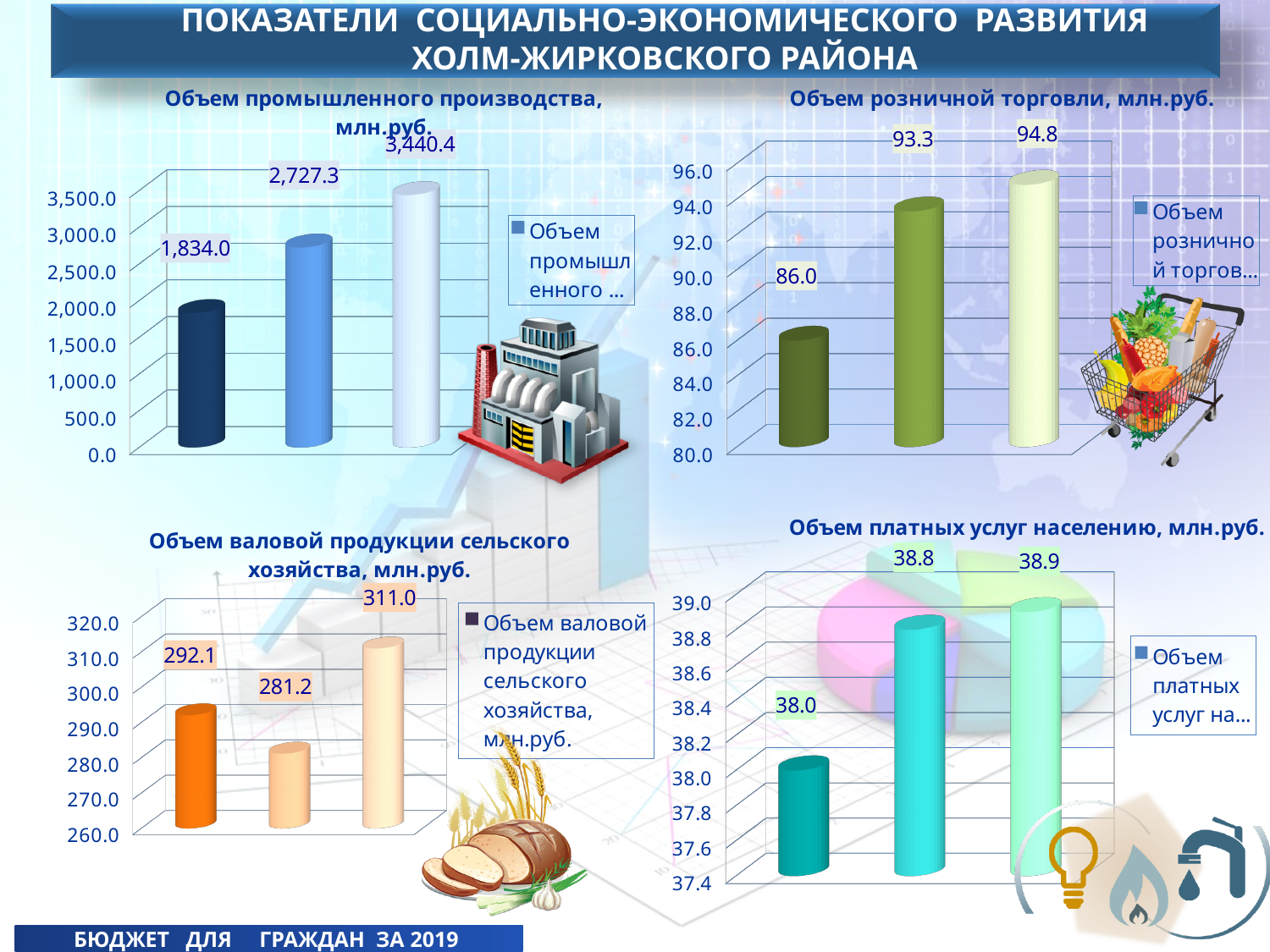
On the chart 'Объем валовой продукции сельского хозяйства, млн.руб.', what is the value of the second bar? 281.2 On the chart 'Объем валовой продукции сельского хозяйства, млн.руб.', which bar is larger: the first or the second? the first (292.1) On the chart 'Объем розничной торговли, млн.руб.', what is the value of the middle bar? 93.3 On the chart 'Объем промышленного производства, млн.руб.', what is the difference between the third bar and the second bar? 713.1 What type of chart is 'Объем платных услуг населению, млн.руб.'? bar chart On the chart 'Объем платных услуг населению, млн.руб.', what is the value of the rightmost bar? 38.9 How many bars are plotted on the chart 'Объем платных услуг населению, млн.руб.'? 3 On the chart 'Объем валовой продукции сельского хозяйства, млн.руб.', what is the difference between the highest and lowest values? 29.8 On the chart 'Объем розничной торговли, млн.руб.', do the values rise or fall from left to right? rise On the chart 'Объем промышленного производства, млн.руб.', what is the value of the first (leftmost) bar? 1,834.0 On the chart 'Объем розничной торговли, млн.руб.', what is the lowest value shown? 86.0 On the chart 'Объем промышленного производства, млн.руб.', what is the value of the tallest bar? 3,440.4